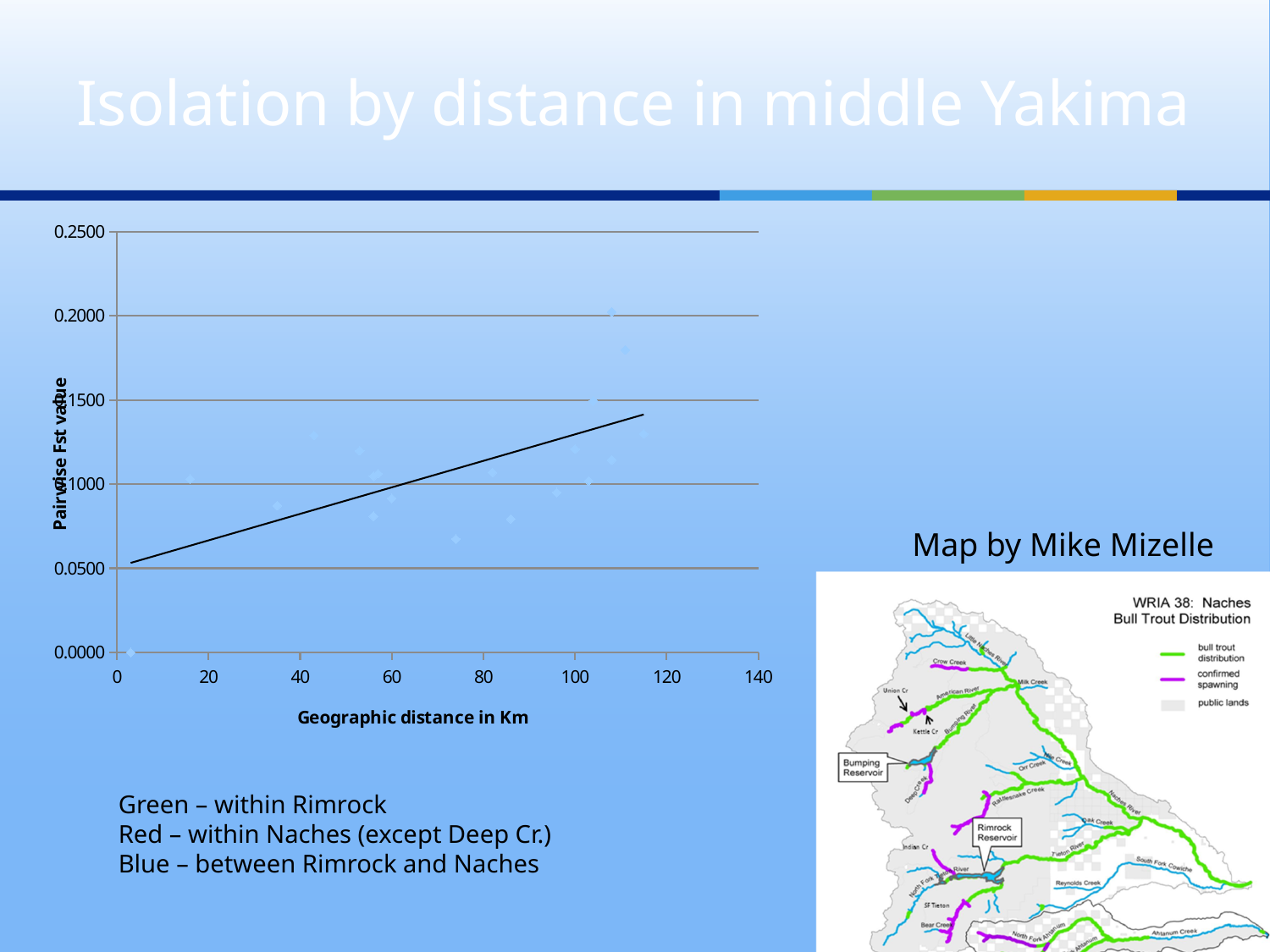
What is the label of the y axis of the chart? Pairwise Fst value Do the values on the chart rise or fall as geographic distance increases along the x axis? rise Is the fitted trend line's value at 100 km greater or less than 0.1500? less What kind of chart is shown on the slide? scatter chart Is the fitted trend line's value at 20 km greater or less than 0.0500? greater What is the label of the x axis of the chart? Geographic distance in Km Is the fitted trend line's value at 110 km greater or less than 0.1000? greater